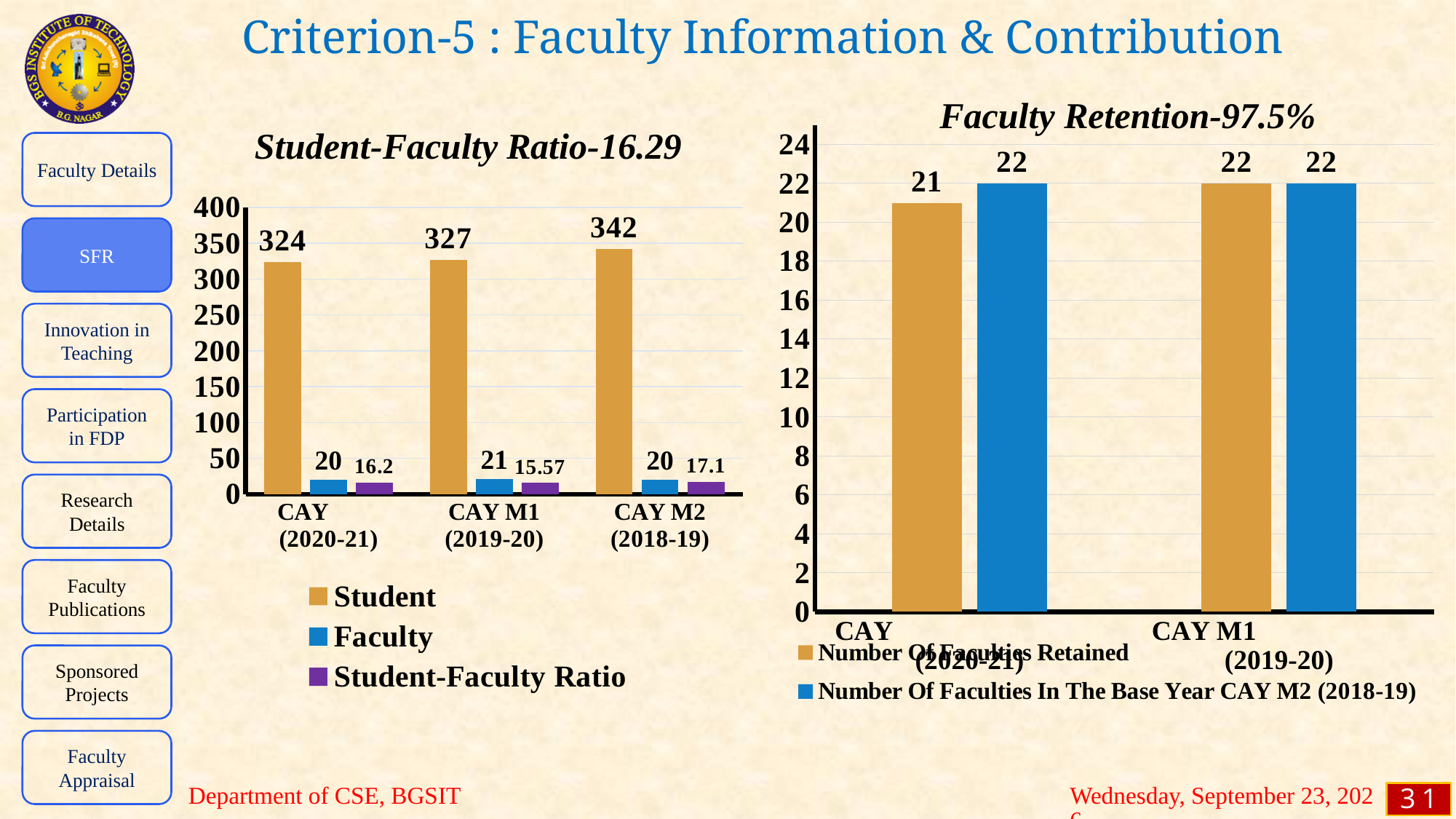
In the Faculty Retention-97.5% chart, how many categories are shown on the x axis? 2 In the Student-Faculty Ratio-16.29 chart, what is the difference between the Student values for CAY M2 (2018-19) and CAY (2020-21)? 18 What type of chart is the Faculty Retention-97.5% chart? bar chart In the Student-Faculty Ratio-16.29 chart, what is the Student value for CAY M2 (2018-19)? 342 In the Faculty Retention-97.5% chart, what is the Number Of Faculties Retained for CAY (2020-21)? 21 In the Student-Faculty Ratio-16.29 chart, which category has the highest Student value? CAY M2 (2018-19) In the Student-Faculty Ratio-16.29 chart, how many series does the legend list? 3 In the Student-Faculty Ratio-16.29 chart, what is the Faculty value for CAY M1 (2019-20)? 21 In the Student-Faculty Ratio-16.29 chart, which category has the lowest Student-Faculty Ratio? CAY M1 (2019-20) In the Faculty Retention-97.5% chart, what is the Number Of Faculties In The Base Year CAY M2 (2018-19) for CAY M1 (2019-20)? 22 In the Student-Faculty Ratio-16.29 chart, what is the Student-Faculty Ratio for CAY (2020-21)? 16.2 In the Student-Faculty Ratio-16.29 chart, do the Student values rise or fall from CAY (2020-21) to CAY M2 (2018-19)? rise